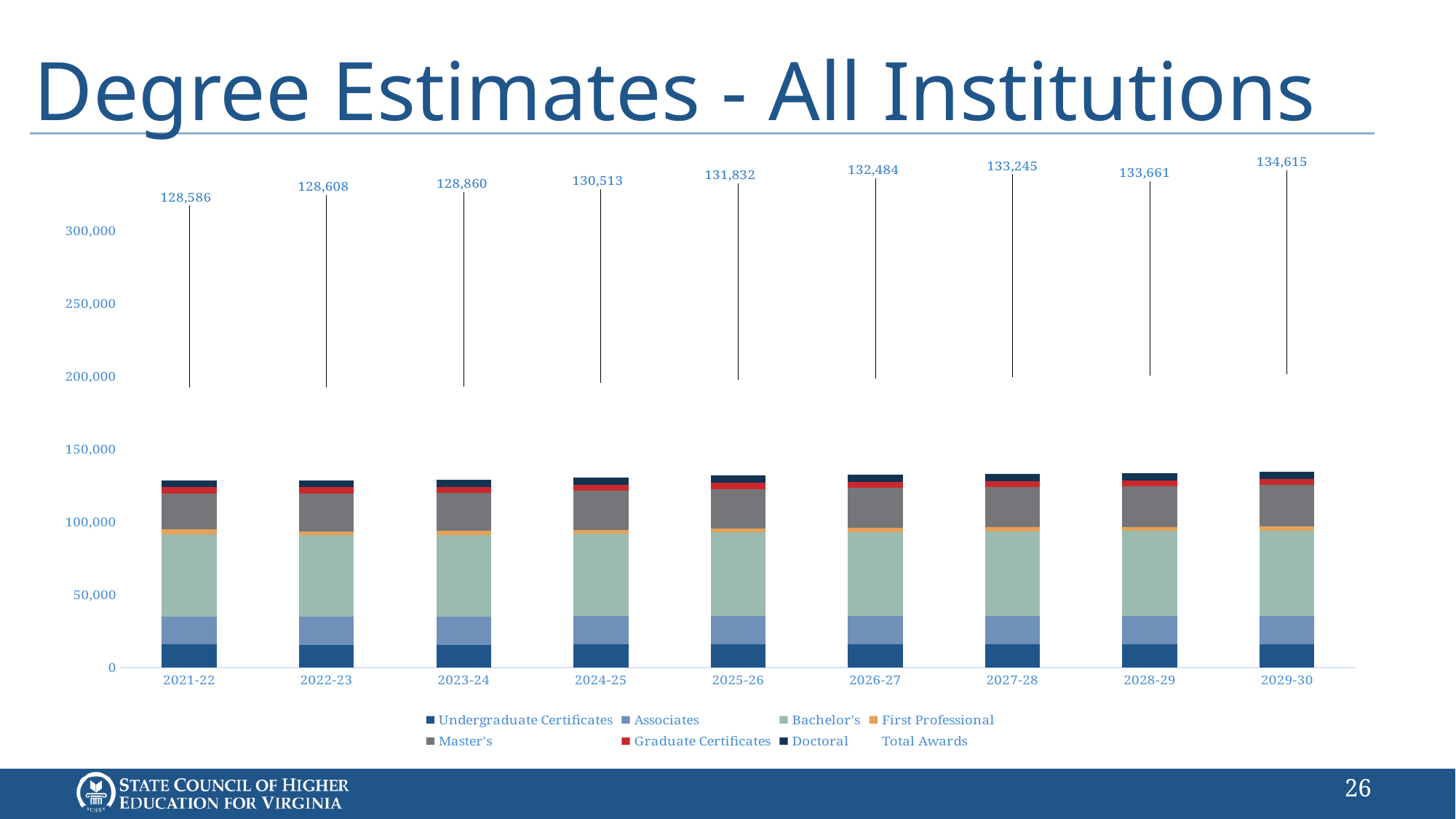
Which is larger, the Total Awards for 2027-28 or for 2024-25? 2027-28 What kind of chart is shown on the slide? stacked bar chart Do the Total Awards values rise or fall from 2021-22 to 2029-30? rise What is the Total Awards value for 2029-30? 134,615 Is the total height of the stacked bar for 2021-22 greater or less than 150,000? less How many academic years are shown on the x axis? 9 What is the Total Awards value for 2025-26? 131,832 How many series does the legend list? 8 What is the difference between the Total Awards for 2029-30 and 2021-22? 6,029 Which year has the highest Total Awards value? 2029-30 What is the Total Awards value for 2021-22? 128,586 Which year has the lowest Total Awards value? 2021-22